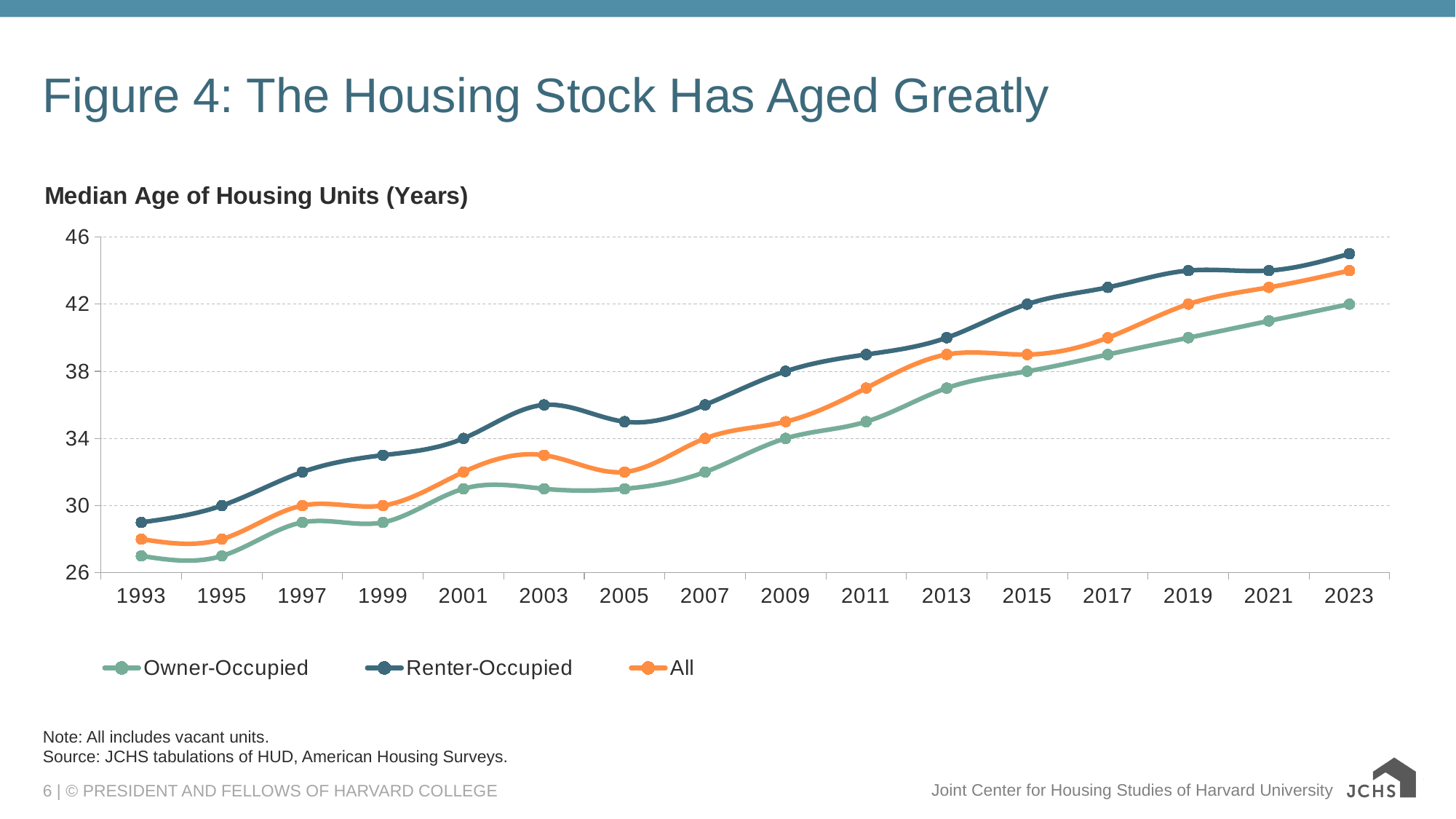
How many years are plotted along the x axis? 16 Is the median age of Owner-Occupied units in 1993 greater or less than 30? less What is the median age of Renter-Occupied housing units in 2015? 42 Is the median age of Renter-Occupied units in 2023 greater or less than 42? greater What is the title of the chart? Median Age of Housing Units (Years) Which series has the highest median age in 2023? Renter-Occupied What is the median age of Owner-Occupied housing units in 2023? 42 What kind of chart is shown on the slide? line chart What is the median age for All housing units in 2007? 34 Do the median age values rise or fall from 1993 to 2023? rise How many series does the legend list? 3 In 2013, which is larger: the median age of Renter-Occupied units or Owner-Occupied units? Renter-Occupied